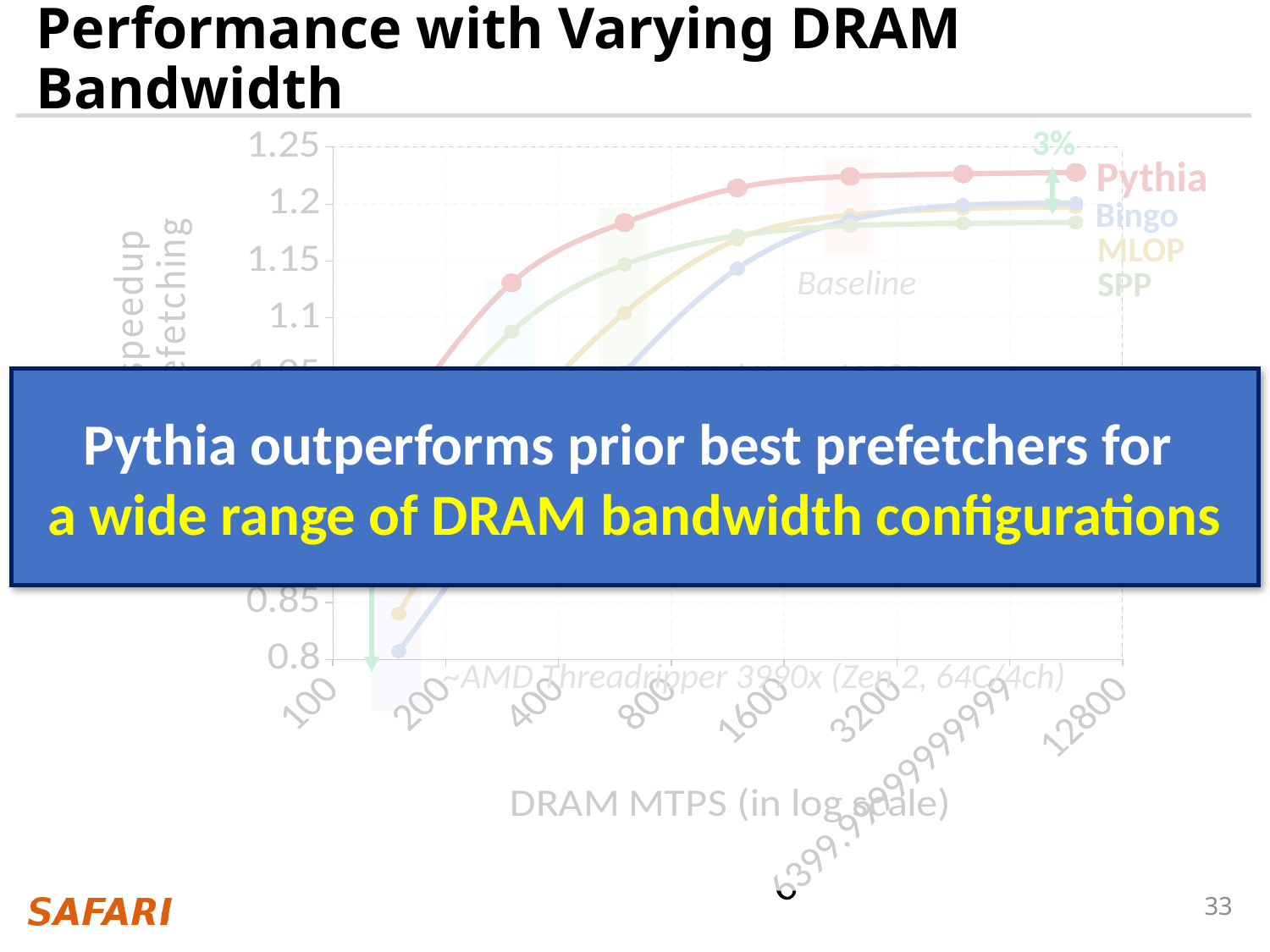
How many series does the chart's legend list? 4 What kind of chart is shown on the slide? line chart Is the value for Pythia at 12800 DRAM MTPS greater or less than 1.2? greater Does the Pythia series rise or fall as DRAM MTPS increases along the x axis? rise What percentage is annotated next to the Pythia line at the right edge of the chart? 3% Is the value for SPP at 12800 DRAM MTPS greater or less than 1.2? less At 800 DRAM MTPS, which series has the larger value, Pythia or Bingo? Pythia How many tick labels are shown on the x axis of the chart? 8 Which series has the highest value at 12800 DRAM MTPS? Pythia Which series has the lowest value at 12800 DRAM MTPS? SPP What is the label of the x axis of the chart? DRAM MTPS (in log scale)